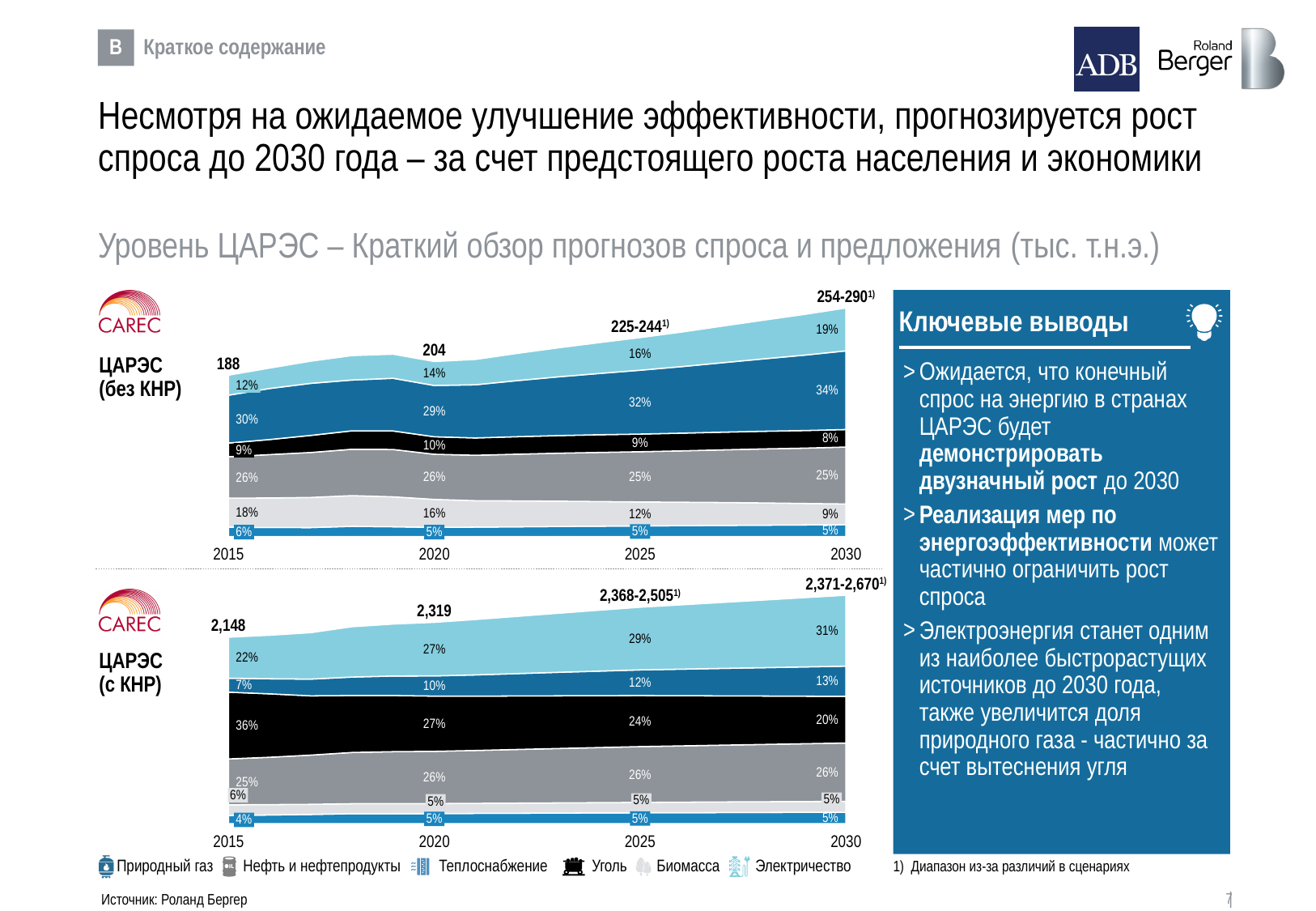
In the bottom chart (ЦАРЭС с КНР), what is the total value shown for 2015? 2,148 In the top chart (ЦАРЭС без КНР), what range is shown for 2030? 254-290 What kind of chart is used for the ЦАРЭС (без КНР) data? stacked area chart In the top chart (ЦАРЭС без КНР), what is the total value shown for 2020? 204 In the bottom chart (ЦАРЭС с КНР), what range is shown for 2030? 2,371-2,670 In the bottom chart (ЦАРЭС с КНР), what is the total value shown for 2020? 2,319 In the bottom chart (ЦАРЭС с КНР), by how much does the total increase from 2015 to 2020? 171 How many energy sources does the legend at the bottom of the slide list? 6 In the bottom chart (ЦАРЭС с КНР), do the totals rise or fall from 2015 to 2030? rise How many years are shown on the x axis of each chart? 4 In the top chart (ЦАРЭС без КНР), what is the total value shown for 2015? 188 In the top chart (ЦАРЭС без КНР), by how much does the total increase from 2015 to 2020? 16